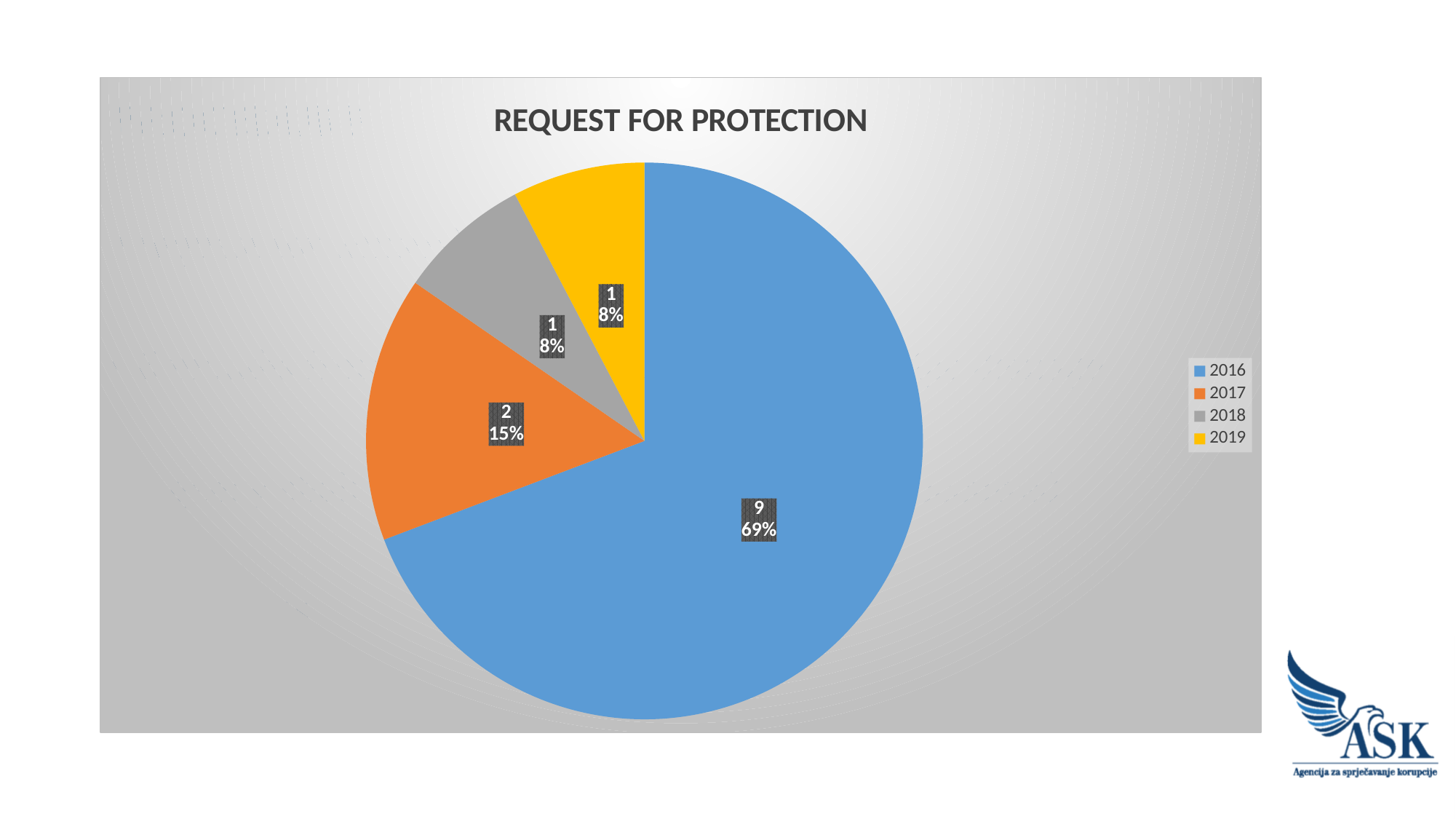
What kind of chart is shown on the slide? pie chart What is the value for 2017? 2 How many entries does the legend list? 4 What share of the pie does 2017 represent? 15% What is the value for 2018? 1 What is the title of the chart? REQUEST FOR PROTECTION What share of the pie does 2016 represent? 69% What is the value for 2016? 9 Which is larger, the value for 2017 or the value for 2019? 2017 What is the difference between the values for 2016 and 2017? 7 How many slices does the pie chart have? 4 Which year has the largest slice? 2016